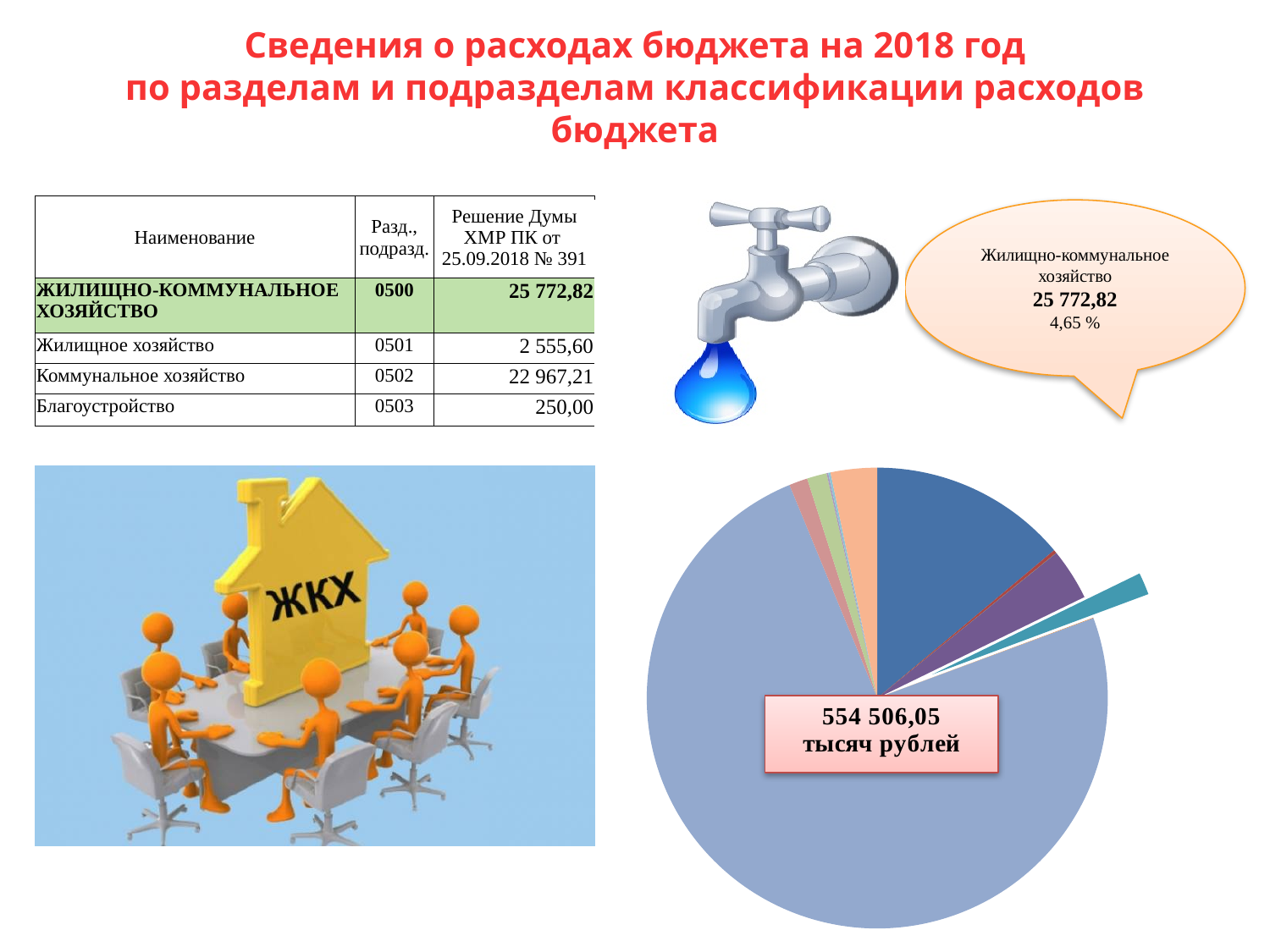
According to the callout next to the pie chart, what is the value for Жилищно-коммунальное хозяйство? 25 772,82 What total amount is printed on the label inside the pie chart? 554 506,05 тысяч рублей According to the callout next to the pie chart, what share of the budget does Жилищно-коммунальное хозяйство represent? 4,65 % What kind of chart is shown at the bottom right of the slide? pie chart In the pie chart, is the largest slice greater or less than half of the pie? greater What colour is the largest slice of the pie chart? light blue Does the pie chart display a legend? No In the pie chart, is the exploded (pulled-out) slice greater or less than 25% of the pie? less